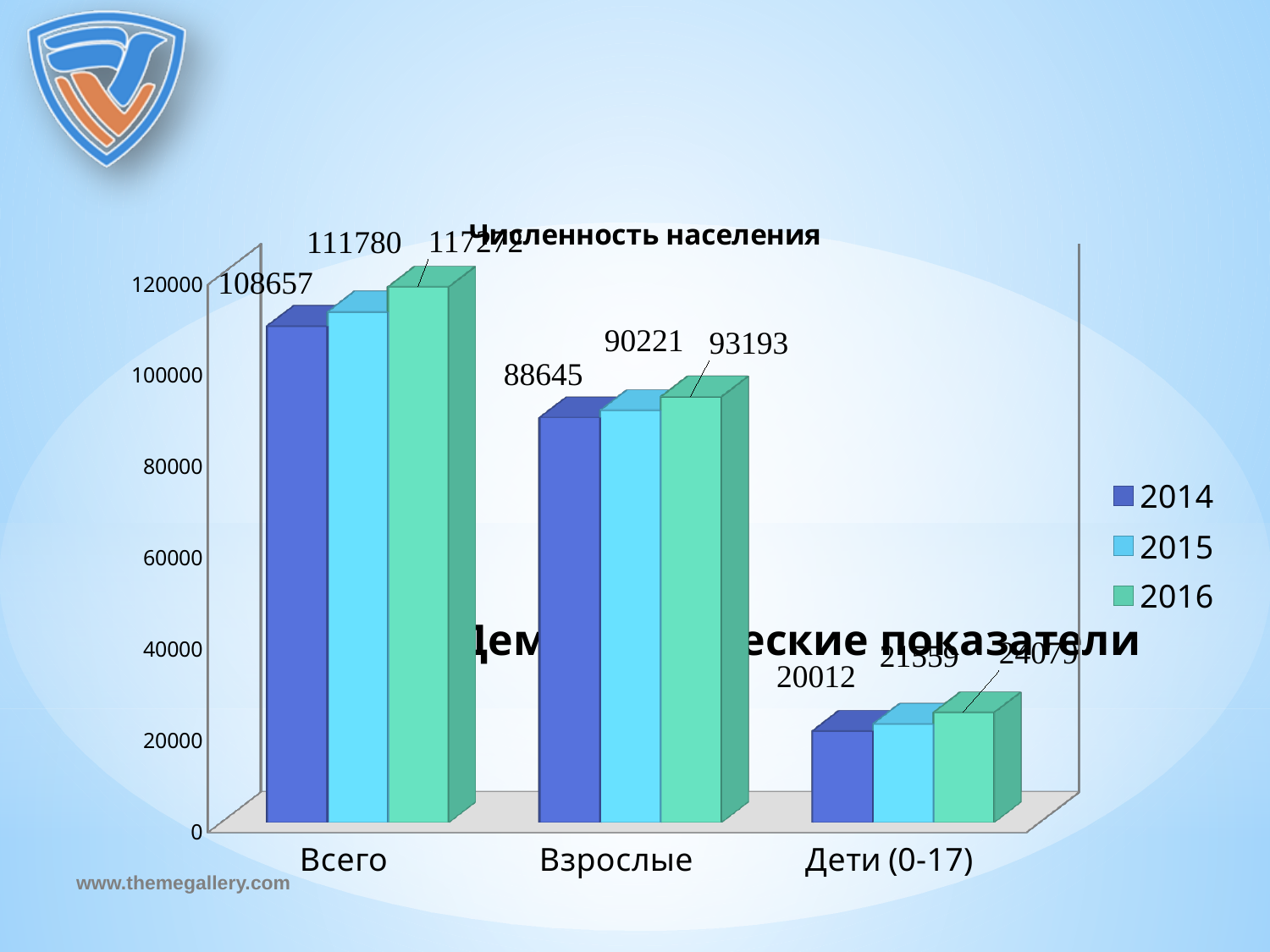
What is the value for Всего in 2015? 111780 What is the value for Всего in 2014? 108657 What is the value for Дети (0-17) in 2014? 20012 By how much did the value for Взрослые increase from 2014 to 2016? 4548 How many series does the legend list? 3 What is the value for Взрослые in 2016? 93193 Which category has the lowest values across all years? Дети (0-17) Which is larger: Взрослые in 2015 or Дети (0-17) in 2014? Взрослые in 2015 Is the value for Дети (0-17) in 2016 greater or less than 20000? greater Within each category, do the values rise or fall from 2014 to 2016? rise What is the value for Взрослые in 2014? 88645 What kind of chart is shown on the slide? bar chart